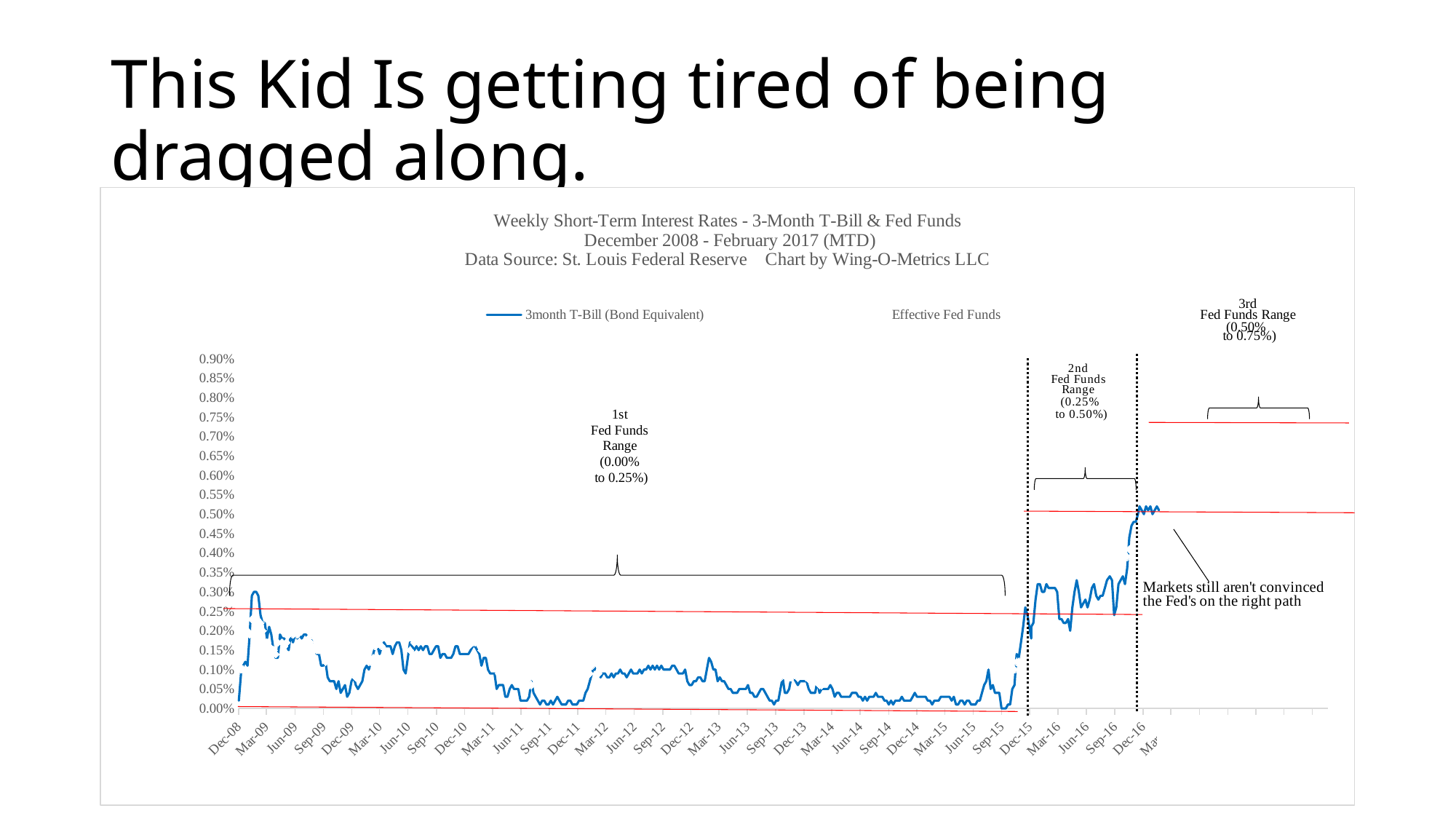
What kind of chart is shown on the slide? line chart Does the 3-month T-Bill line rise or fall between Sep-15 and Dec-16? rise How many Fed Funds ranges are annotated on the chart? 3 What range is labelled as the 1st Fed Funds Range on the chart? 0.00% to 0.25% Is the 3-month T-Bill value around Sep-11 greater or less than 0.05%? less What is the data source named on the chart? St. Louis Federal Reserve What is the title of the chart? Weekly Short-Term Interest Rates - 3-Month T-Bill & Fed Funds What range is labelled as the 2nd Fed Funds Range on the chart? 0.25% to 0.50% How many series does the chart's legend list? 2 What is the highest value shown on the chart's y axis? 0.90% What range is labelled as the 3rd Fed Funds Range on the chart? 0.50% to 0.75% Is the 3-month T-Bill value around Dec-16 greater or less than 0.40%? greater